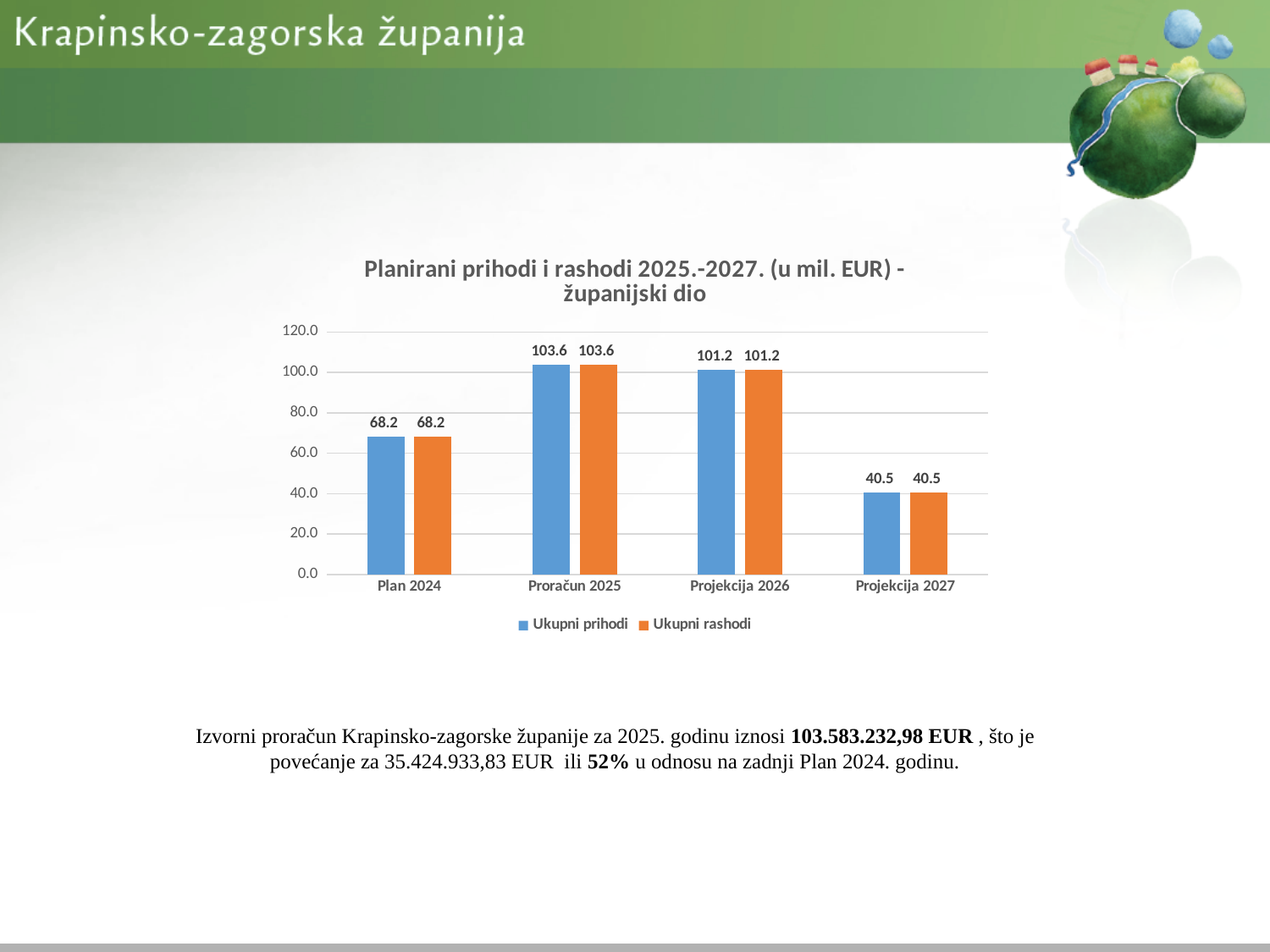
How many series does the legend list? 2 What is the difference between Ukupni prihodi for Proračun 2025 and Plan 2024? 35.4 Which category has the highest value for Ukupni prihodi? Proračun 2025 Is the value of Ukupni rashodi for Projekcija 2026 greater or less than 100.0? greater What is the value of Ukupni prihodi for Plan 2024? 68.2 How many categories are shown on the x axis? 4 What is the value of Ukupni prihodi for Proračun 2025? 103.6 What kind of chart is shown on the slide? Bar chart Which category has the lowest value for Ukupni rashodi? Projekcija 2027 What is the value of Ukupni rashodi for Projekcija 2027? 40.5 What is the title of the chart? Planirani prihodi i rashodi 2025.-2027. (u mil. EUR) - županijski dio Which is larger: Ukupni prihodi for Projekcija 2026 or for Projekcija 2027? Projekcija 2026